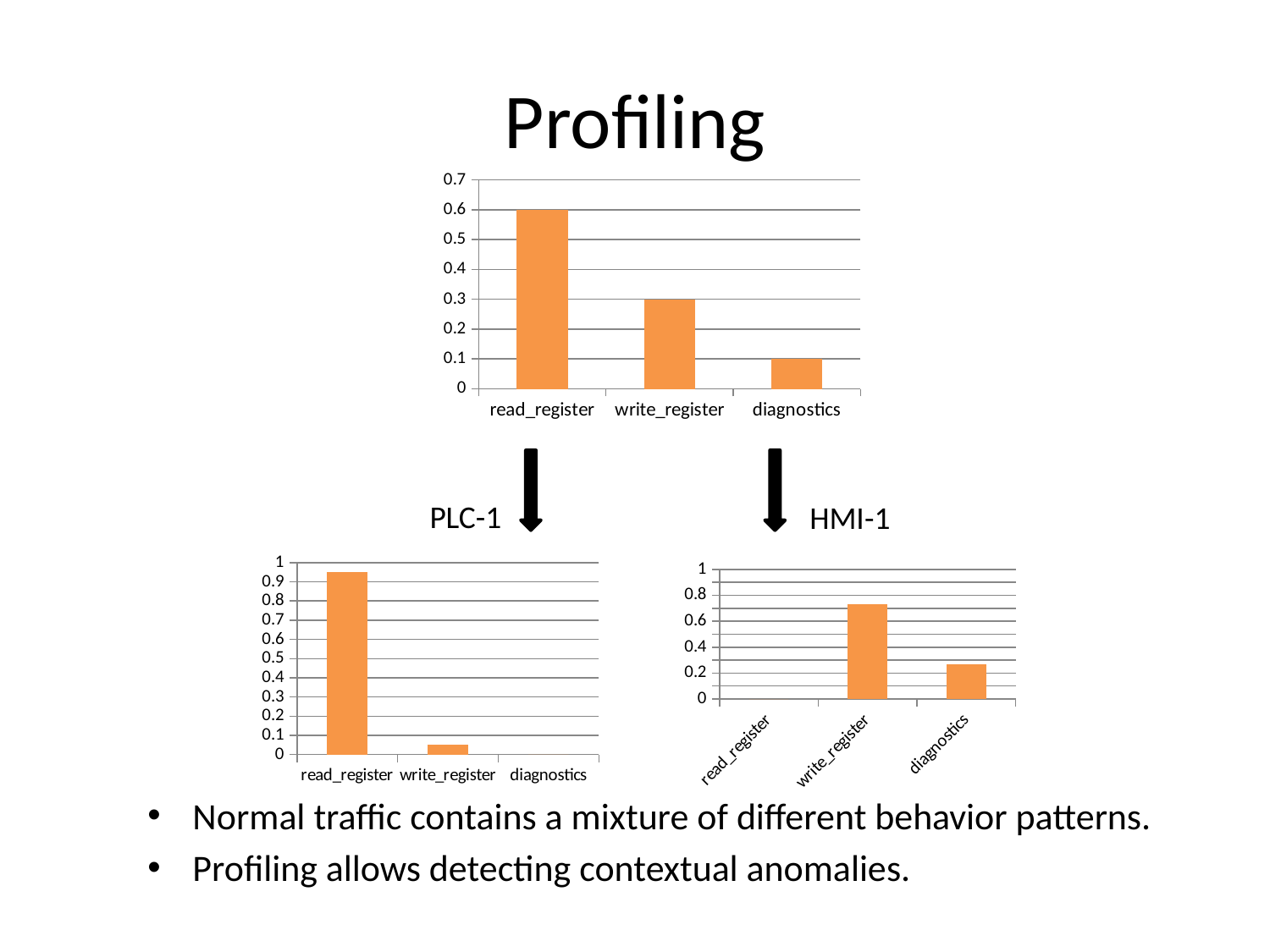
In the top chart, which category has the highest value? read_register In the top chart, do the values rise or fall from left to right along the x axis? fall In the HMI-1 chart, is the value for write_register greater or less than 0.6? greater In the PLC-1 chart, which category has the lowest value? diagnostics In the top chart, what is the value for read_register? 0.6 In the PLC-1 chart, is the value for read_register greater or less than 0.9? greater What kind of chart is the PLC-1 chart? bar chart In the top chart, what is the value for diagnostics? 0.1 In the top chart, what is the difference between the values for read_register and write_register? 0.3 In the top chart, what is the value for write_register? 0.3 How many categories are shown on the x axis of the HMI-1 chart? 3 In the HMI-1 chart, which is larger, the value for write_register or the value for diagnostics? write_register